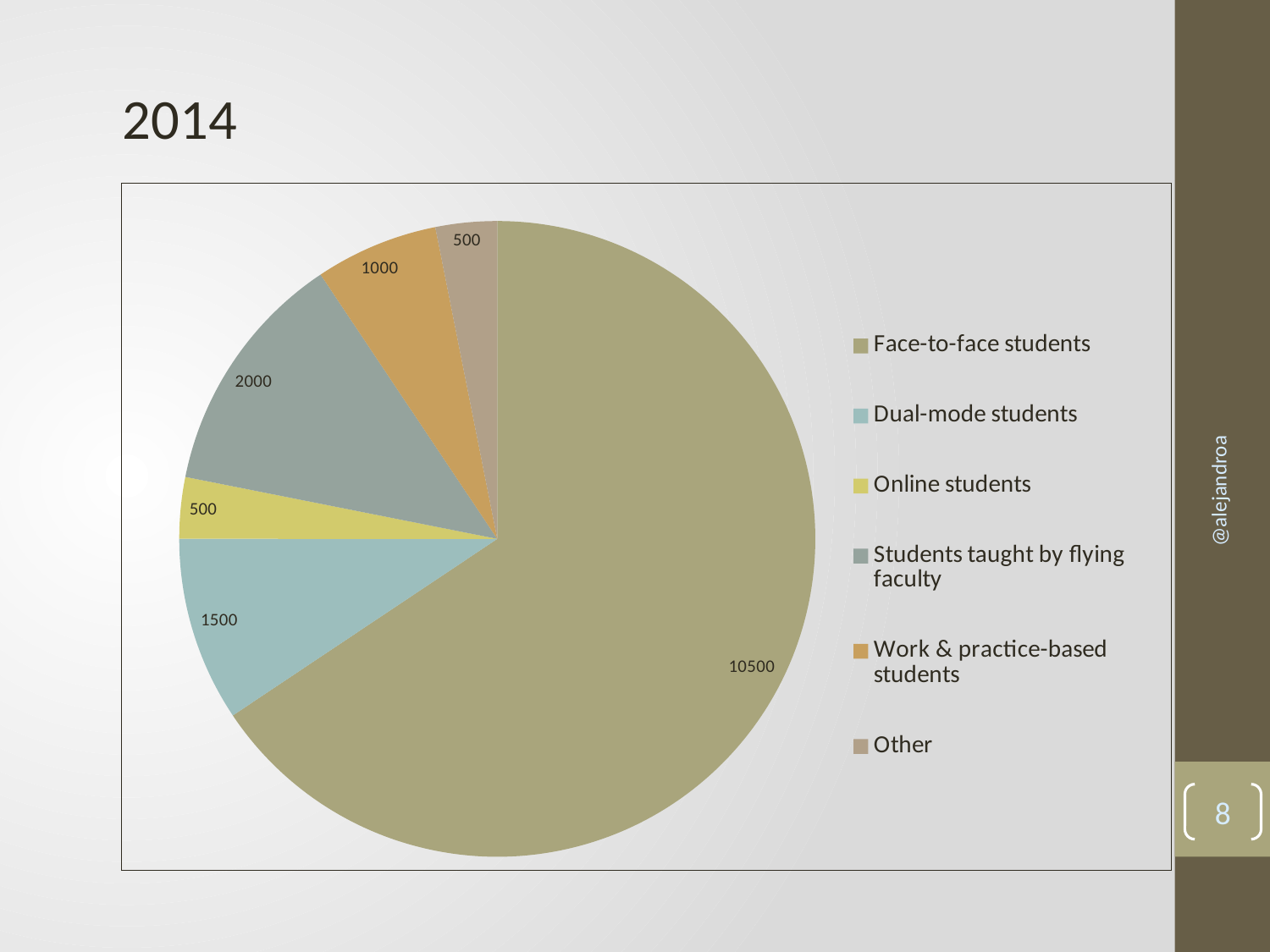
What is the value for Dual-mode students? 1500 What kind of chart is shown on the slide? Pie chart What share of the pie does the Students taught by flying faculty slice represent? 12.5% How many categories does the pie chart have? 6 What is the value for Students taught by flying faculty? 2000 What is the total of all the slices in the pie chart? 16000 Which category has the largest slice of the pie? Face-to-face students What is the value for Face-to-face students? 10500 What is the value for Work & practice-based students? 1000 Which is larger, the value for Students taught by flying faculty or the value for Work & practice-based students? Students taught by flying faculty What is the value for Online students? 500 What is the difference between the values for Face-to-face students and Dual-mode students? 9000